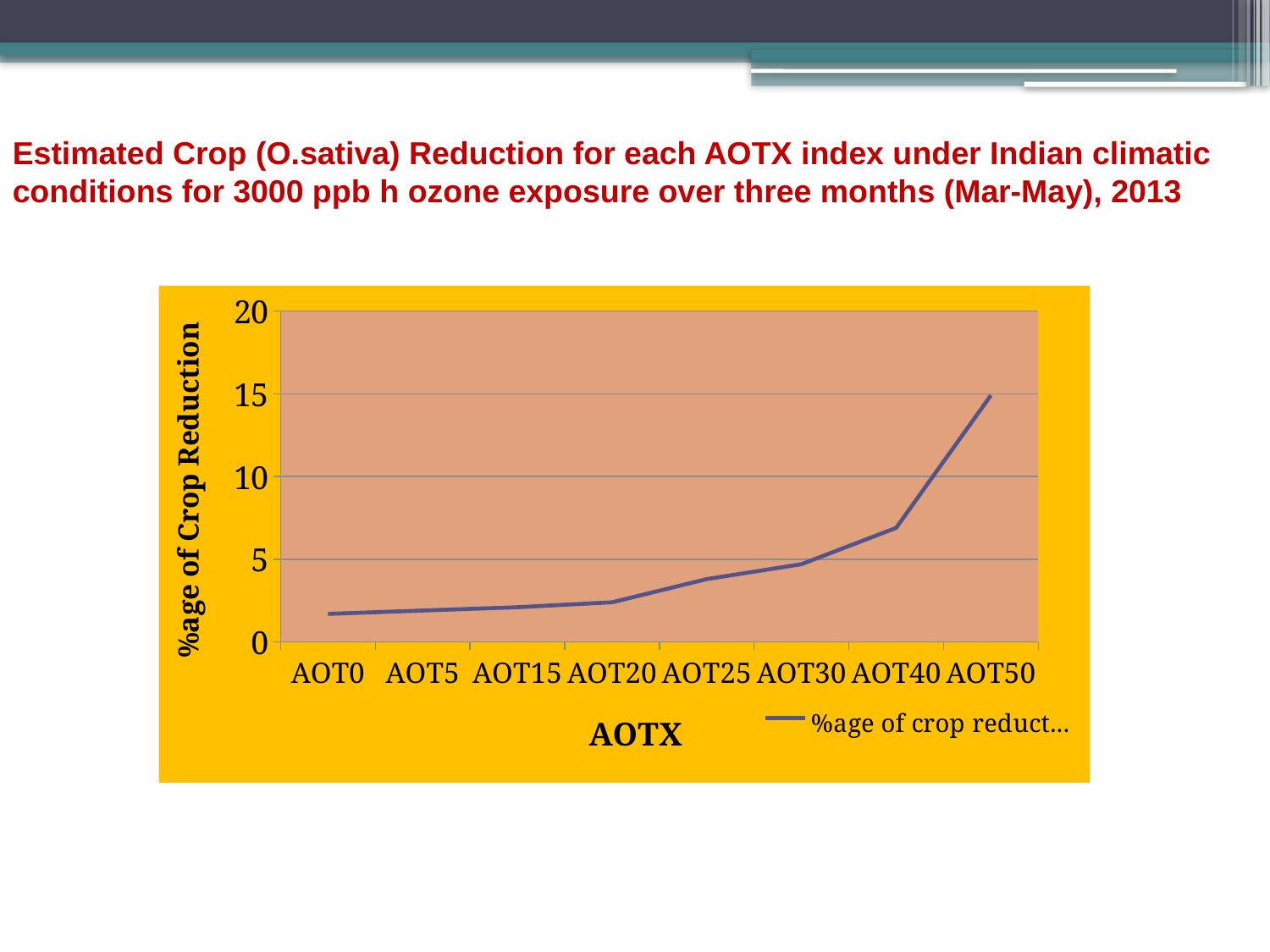
How many AOTX categories are plotted along the x axis? 8 Which AOTX index has the highest percentage of crop reduction? AOT50 Do the values rise or fall as you move from AOT0 to AOT50 along the x axis? rise Is the value for AOT0 greater or less than 5? less Which has a larger percentage of crop reduction, AOT0 or AOT30? AOT30 How many series does the legend list? 1 Which has a larger percentage of crop reduction, AOT40 or AOT50? AOT50 What is the title of the x axis of the chart? AOTX What kind of chart is shown on the slide? line chart Is the value for AOT25 greater or less than 5? less Is the value for AOT40 greater or less than 5? greater